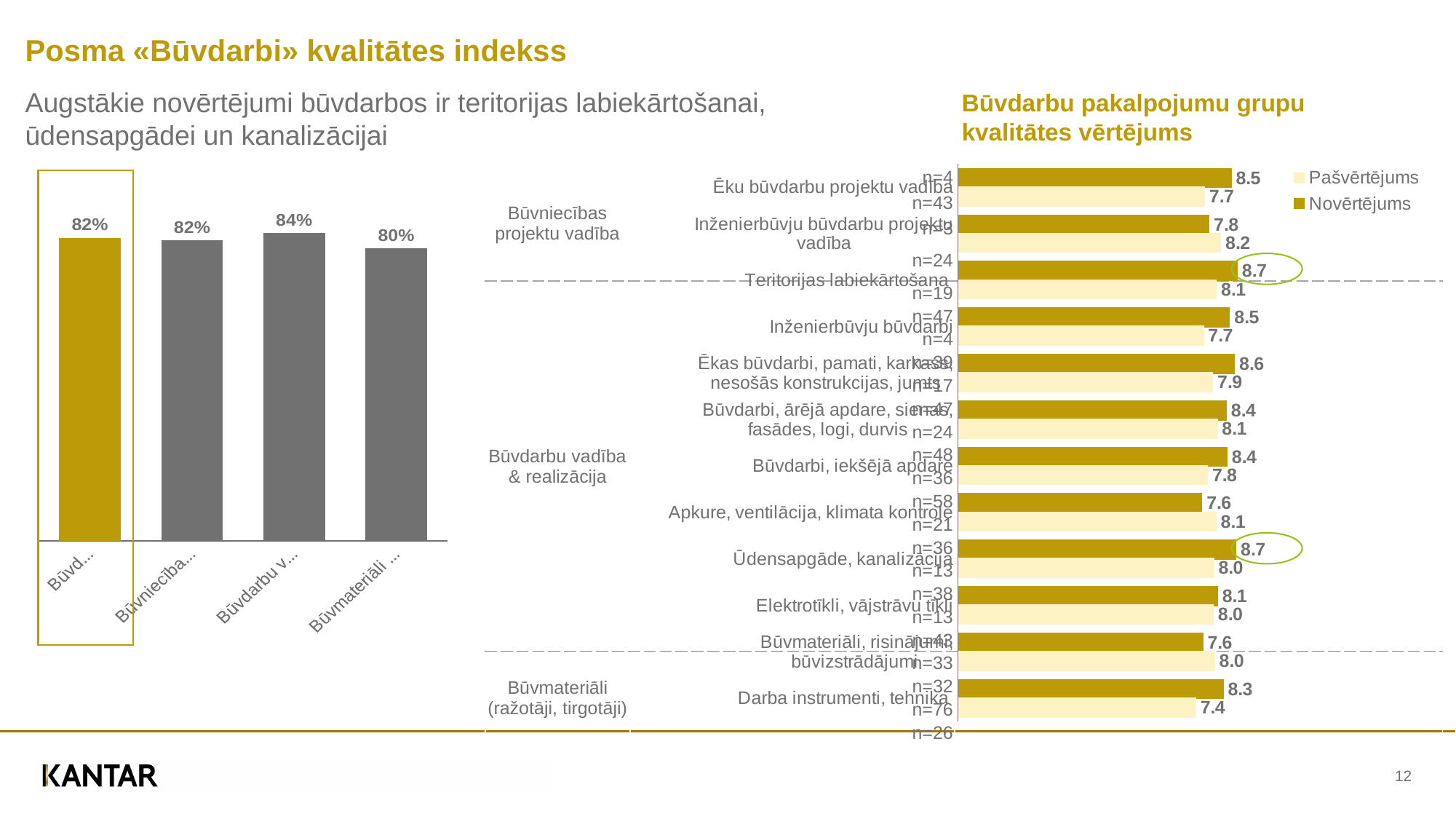
On the chart 'Būvdarbu pakalpojumu grupu kvalitātes vērtējums', which is larger for Inženierbūvju būvdarbu projektu vadība: Pašvērtējums or Novērtējums? Pašvērtējums On the chart 'Būvdarbu pakalpojumu grupu kvalitātes vērtējums', what is the difference between the Novērtējums and Pašvērtējums values for Darba instrumenti, tehnika? 0.9 On the left bar chart, what is the value of the third bar? 84% On the chart 'Būvdarbu pakalpojumu grupu kvalitātes vērtējums', how many series does the legend list? 2 On the left bar chart, what is the value of the highlighted first bar? 82% On the chart 'Būvdarbu pakalpojumu grupu kvalitātes vērtējums', what is the Pašvērtējums value for Apkure, ventilācija, klimata kontrole? 8.1 On the left bar chart, which bar has the lowest value? The fourth bar (Būvmateriāli ...), 80% On the chart 'Būvdarbu pakalpojumu grupu kvalitātes vērtējums', how many service groups (categories) are plotted? 12 What type of chart is 'Būvdarbu pakalpojumu grupu kvalitātes vērtējums'? Bar chart On the chart 'Būvdarbu pakalpojumu grupu kvalitātes vērtējums', what is the Novērtējums value for Teritorijas labiekārtošana? 8.7 On the chart 'Būvdarbu pakalpojumu grupu kvalitātes vērtējums', what is the Pašvērtējums value for Darba instrumenti, tehnika? 7.4 On the left bar chart, how many bars are shown? 4